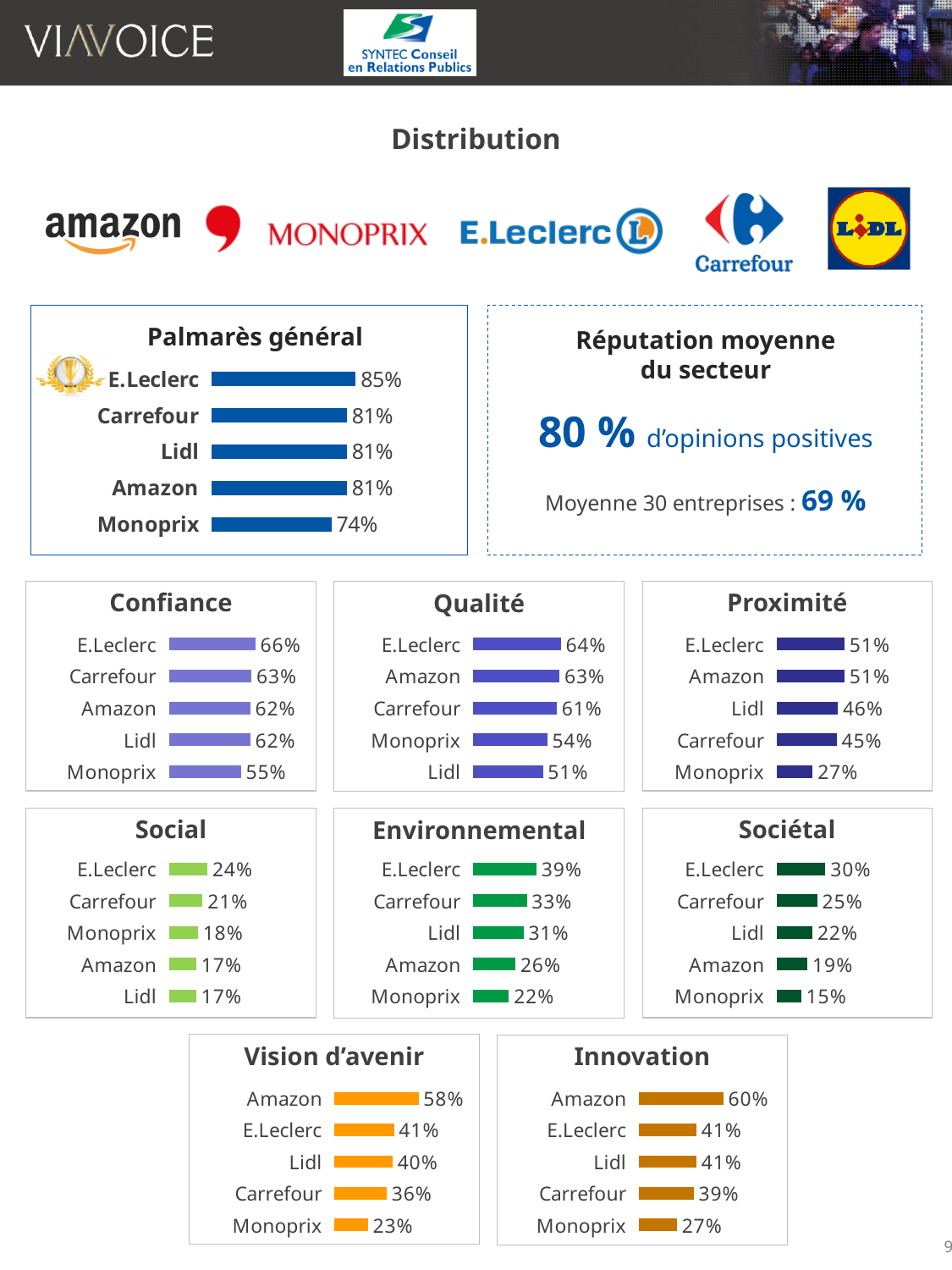
In the 'Confiance' chart, what is the difference between E.Leclerc and Monoprix? 11% In the 'Environnemental' chart, which is larger, the value for Carrefour or the value for Amazon? Carrefour In the 'Vision d'avenir' chart, which company has the highest value? Amazon In the 'Qualité' chart, what is the value for Amazon? 63% What kind of chart is the 'Palmarès général' chart? Bar chart In the 'Palmarès général' chart, what is the value for E.Leclerc? 85% In the 'Sociétal' chart, what is the value for Lidl? 22% In the 'Social' chart, how many companies are shown? 5 In the 'Vision d'avenir' chart, what is the value for Carrefour? 36% In the 'Proximité' chart, which company has the lowest value? Monoprix In the 'Innovation' chart, what is the difference between Amazon and Monoprix? 33% In the 'Palmarès général' chart, which company has the lowest value? Monoprix